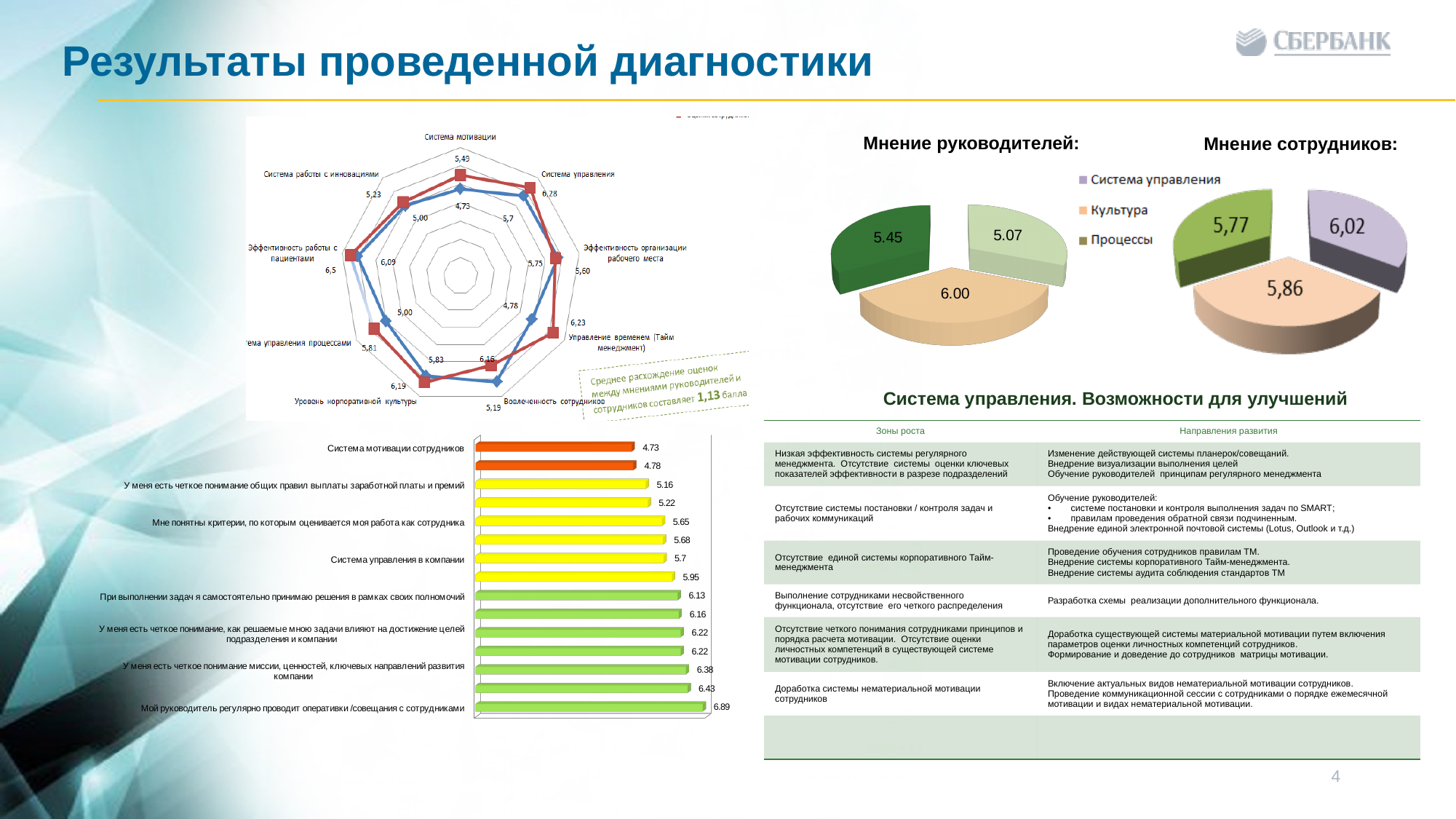
How many categories does the legend next to the pie charts list? 3 In the bar chart at the bottom left, what is the smallest value shown? 4.73 What kind of chart is shown at the top left of the slide? radar chart In the pie chart titled 'Мнение сотрудников', what is the value for 'Система управления'? 6,02 In the bar chart at the bottom left, what is the value of the longest bar, labelled 'Мой руководитель регулярно проводит оперативки /совещания с сотрудниками'? 6.89 In the bar chart at the bottom left, what is the difference between the largest value (6.89) and the smallest value (4.73)? 2.16 In the pie chart titled 'Мнение руководителей', what is the largest value shown? 6.00 In the pie chart titled 'Мнение сотрудников', which category has the lowest value? Процессы In the pie chart titled 'Мнение руководителей', what is the smallest value shown? 5.07 In the pie chart titled 'Мнение сотрудников', what is the value for 'Культура'? 5,86 What kind of chart is used for 'Мнение руководителей' and 'Мнение сотрудников'? pie chart In the pie chart titled 'Мнение руководителей', what is the difference between the largest and smallest values? 0.93